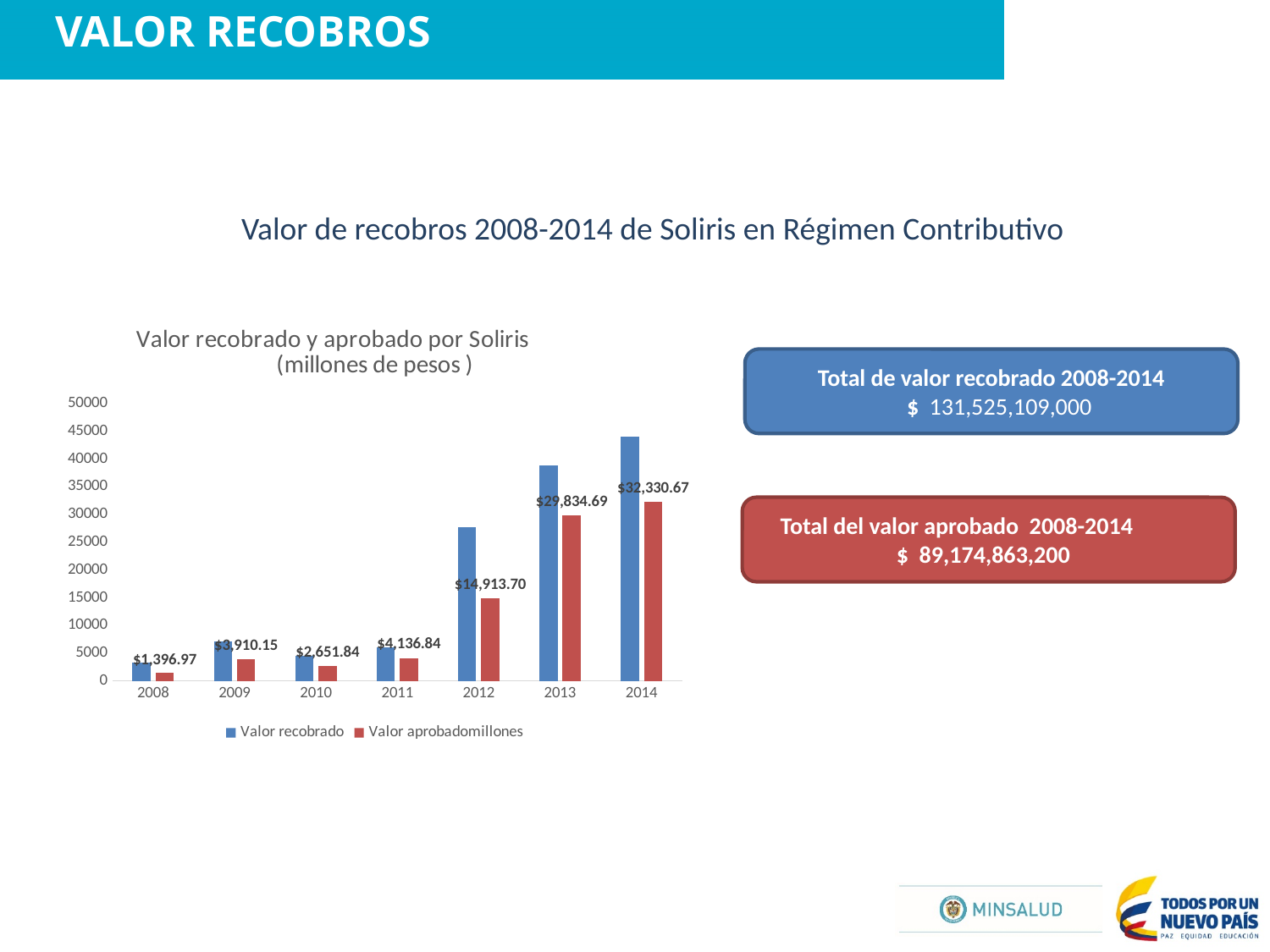
How many series does the chart's legend list? 2 Which year has the highest Valor aprobado? 2014 Is the Valor recobrado value for 2012 greater or less than 25000? greater Is the Valor recobrado value for 2014 greater or less than 40000? greater What is the Valor aprobado value for 2008? $1,396.97 How many years are shown on the x axis of the chart? 7 What kind of chart is shown on the slide? bar chart What is the difference between the Valor aprobado values for 2014 and 2013? $2,495.98 What is the Valor aprobado value for 2014? $32,330.67 Which year has the larger Valor aprobado, 2009 or 2010? 2009 Which year has the lowest Valor aprobado? 2008 What is the Valor aprobado value for 2012? $14,913.70